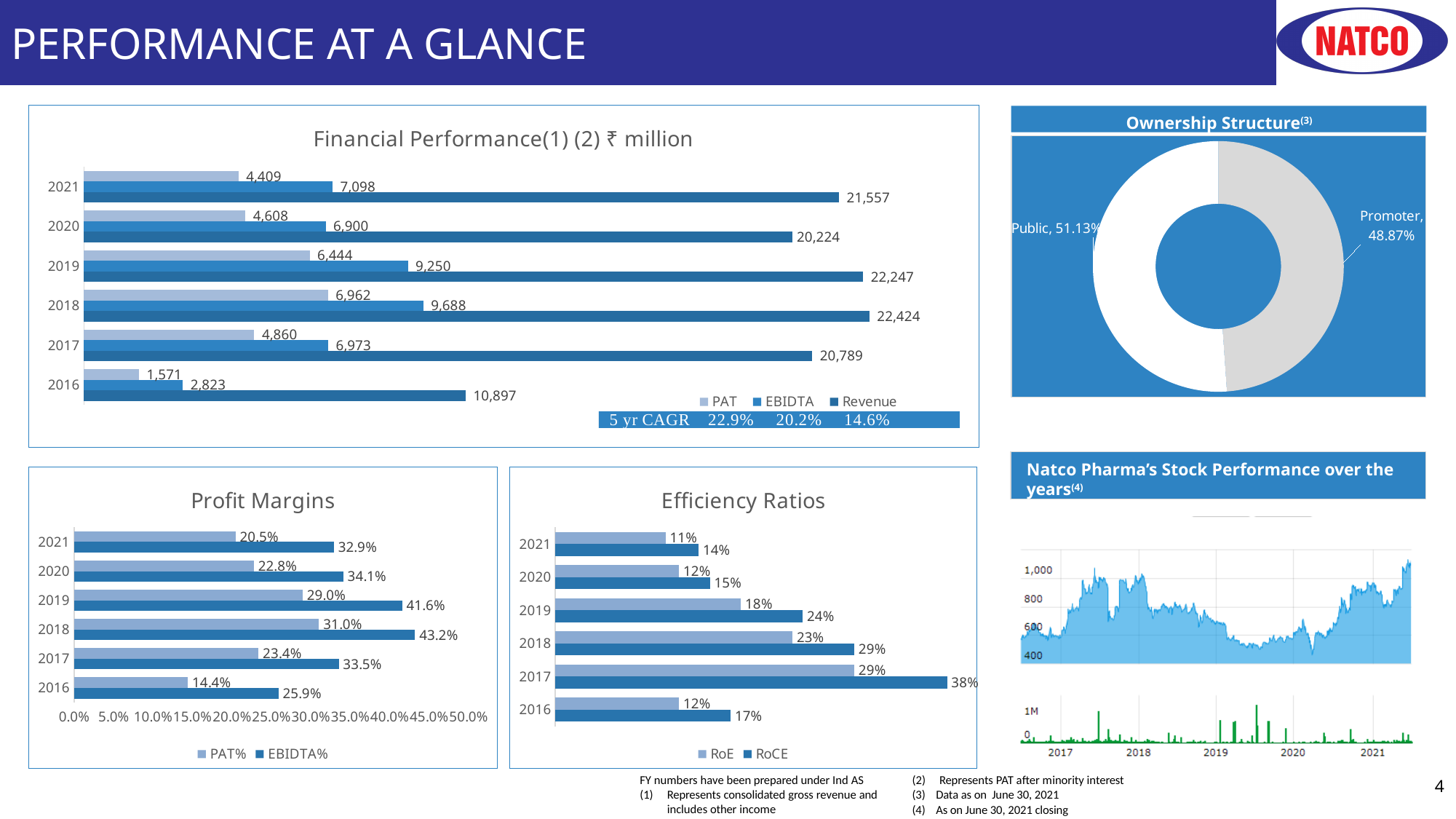
In the Financial Performance chart, which year has the highest Revenue? 2018 In the Financial Performance chart, what is the difference between EBIDTA in 2018 and EBIDTA in 2019? 438 In the Efficiency Ratios chart, is RoE for 2019 larger or smaller than RoE for 2018? smaller In the Profit Margins chart, which year has the lowest PAT%? 2016 How many series does the legend of the Financial Performance chart list? 3 In the Financial Performance chart, what is the Revenue value for 2021? 21,557 What kind of chart is the Ownership Structure chart? Donut (pie) chart In the Profit Margins chart, what is the EBIDTA% for 2018? 43.2% In the Financial Performance chart, which year has the lowest PAT? 2016 How many years are shown on the Efficiency Ratios chart? 6 In the Efficiency Ratios chart, what is the RoCE for 2017? 38% In the Ownership Structure chart, what share is held by the Public? 51.13%